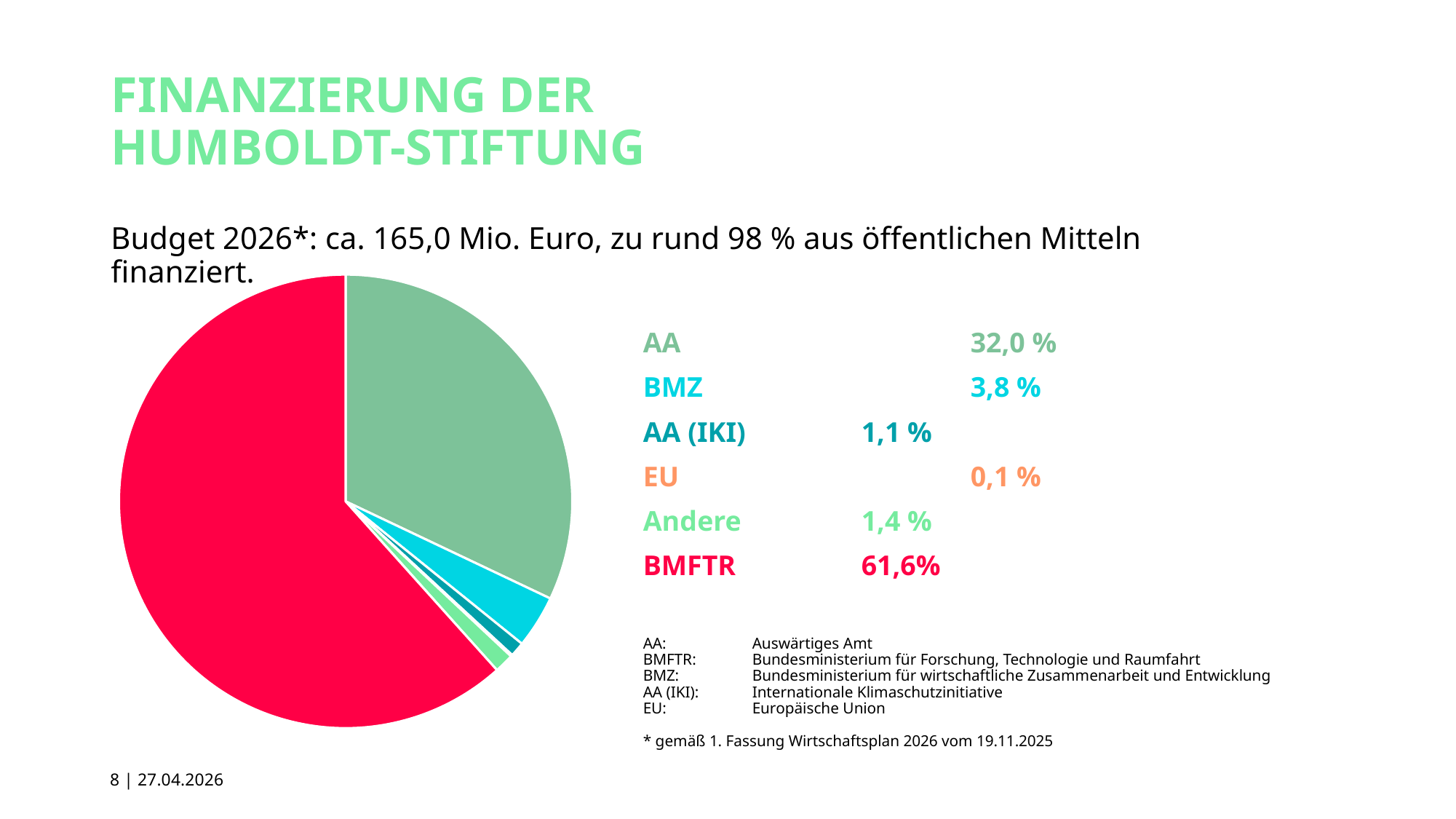
How many funding sources are listed in the legend? 6 What share of the funding comes from BMZ? 3,8 % Which is larger, the share for BMZ or the share for Andere? BMZ What share of the funding comes from BMFTR? 61,6% What share of the funding is listed as Andere? 1,4 % What share of the funding comes from AA (IKI)? 1,1 % What share of the funding comes from EU? 0,1 % Which funding source has the largest share of the pie? BMFTR What share of the funding comes from AA? 32,0 % Which funding source has the smallest share of the pie? EU What type of chart is shown on the slide? pie chart What is the difference between the BMFTR share and the AA share? 29,6 %